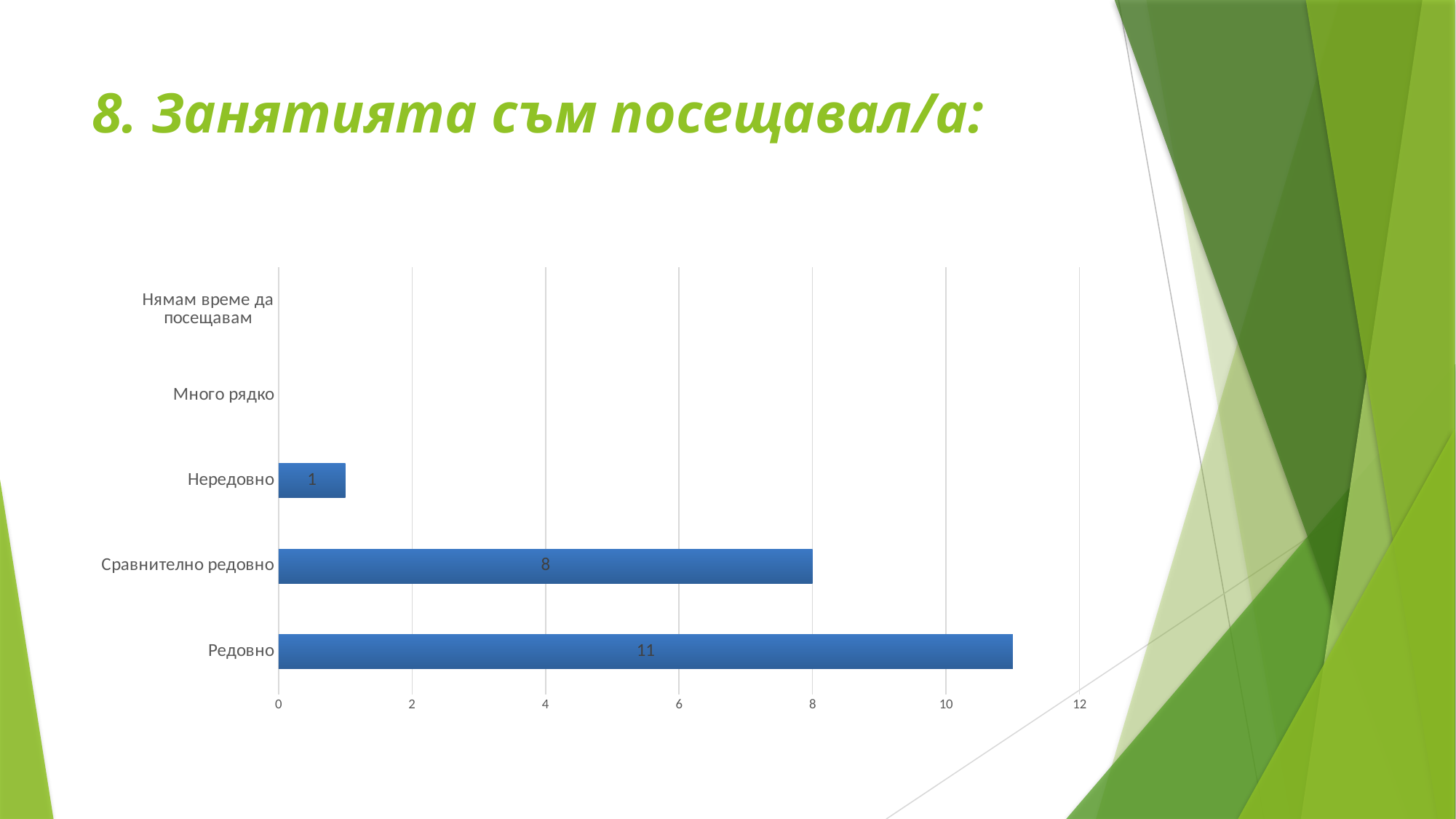
Is the value for Нередовно greater or less than 2? less What is the title of the slide? 8. Занятията съм посещавал/а: How many categories are shown on the chart? 5 What is the value for Сравнително редовно? 8 What is the value for Редовно? 11 Is the value for Редовно greater or less than 10? greater What is the value for Нередовно? 1 What is the difference between the values for Сравнително редовно and Нередовно? 7 Which is larger, the value for Сравнително редовно or the value for Нередовно? Сравнително редовно What kind of chart is shown on the slide? bar chart Which category has the highest value? Редовно What is the difference between the values for Редовно and Сравнително редовно? 3